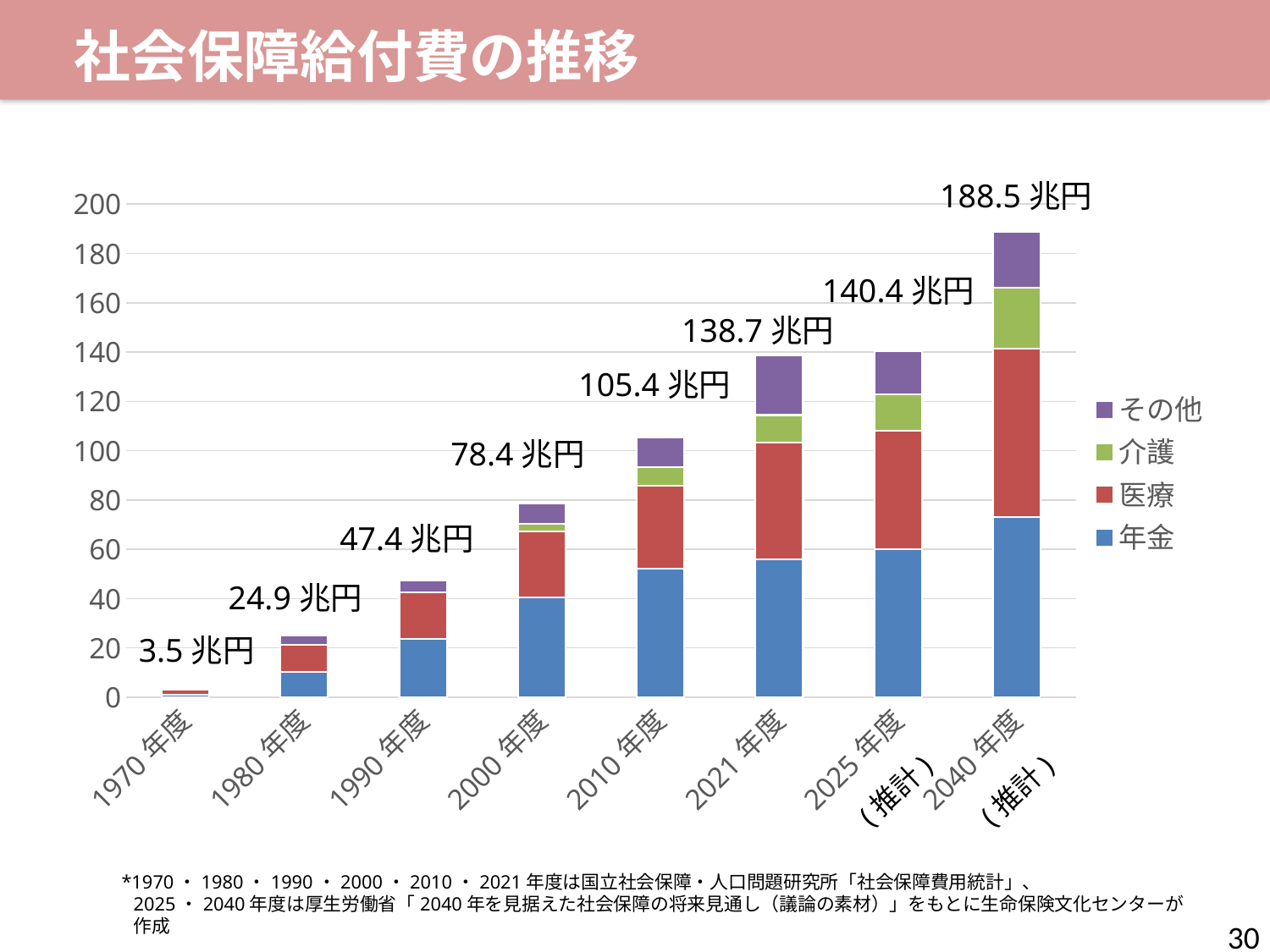
How many series does the legend list? 4 What is the difference between the totals for 2021年度 and 2010年度? 33.3 兆円 What is the total social security benefit shown for 2040年度（推計）? 188.5 兆円 How many fiscal years are shown on the x axis? 8 Which fiscal year has the highest total social security benefit? 2040年度（推計） Which is larger, the total for 1990年度 or the total for 2000年度? 2000年度 What is the total value labeled for 1970年度? 3.5 兆円 Is the 年金 segment for 2040年度（推計） greater or less than 60? greater Which fiscal year has the lowest total social security benefit? 1970年度 Do the total values rise or fall from 1970年度 to 2040年度（推計）? rise What is the total value labeled for 2000年度? 78.4 兆円 What is the difference between the totals for 2040年度（推計） and 2025年度（推計）? 48.1 兆円